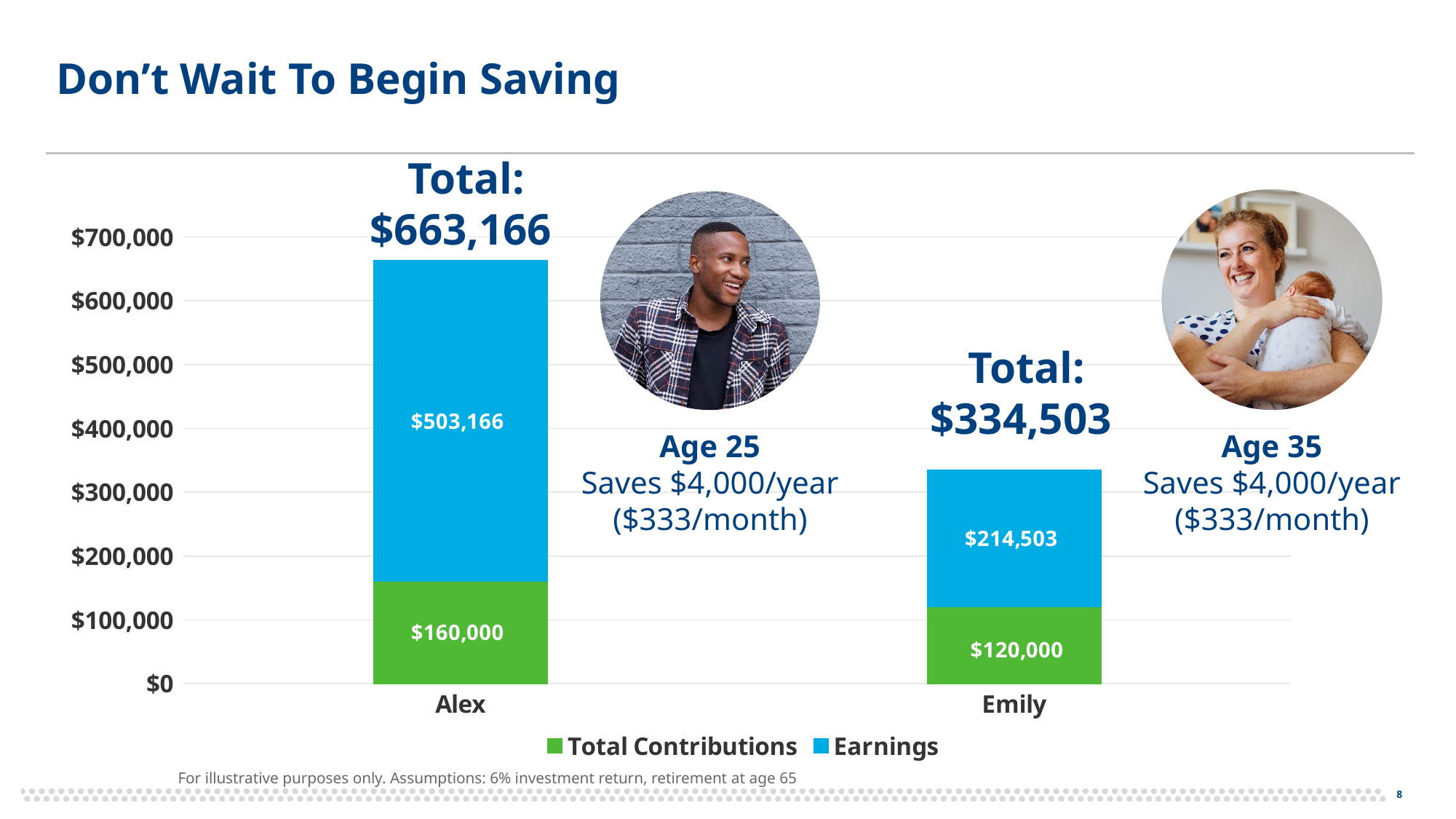
How many categories are shown on the x axis? 2 What kind of chart is shown on the slide? Stacked bar chart Which category has the lowest Total Contributions value? Emily What is the total of the stacked bar for Emily? $334,503 Which category has the higher Earnings value, Alex or Emily? Alex What is the Total Contributions value for Alex? $160,000 What is the difference between Alex's Earnings and Emily's Earnings? $288,663 What is the Total Contributions value for Emily? $120,000 How many series does the legend list? 2 What is the total of the stacked bar for Alex? $663,166 What is the Earnings value for Emily? $214,503 What is the Earnings value for Alex? $503,166